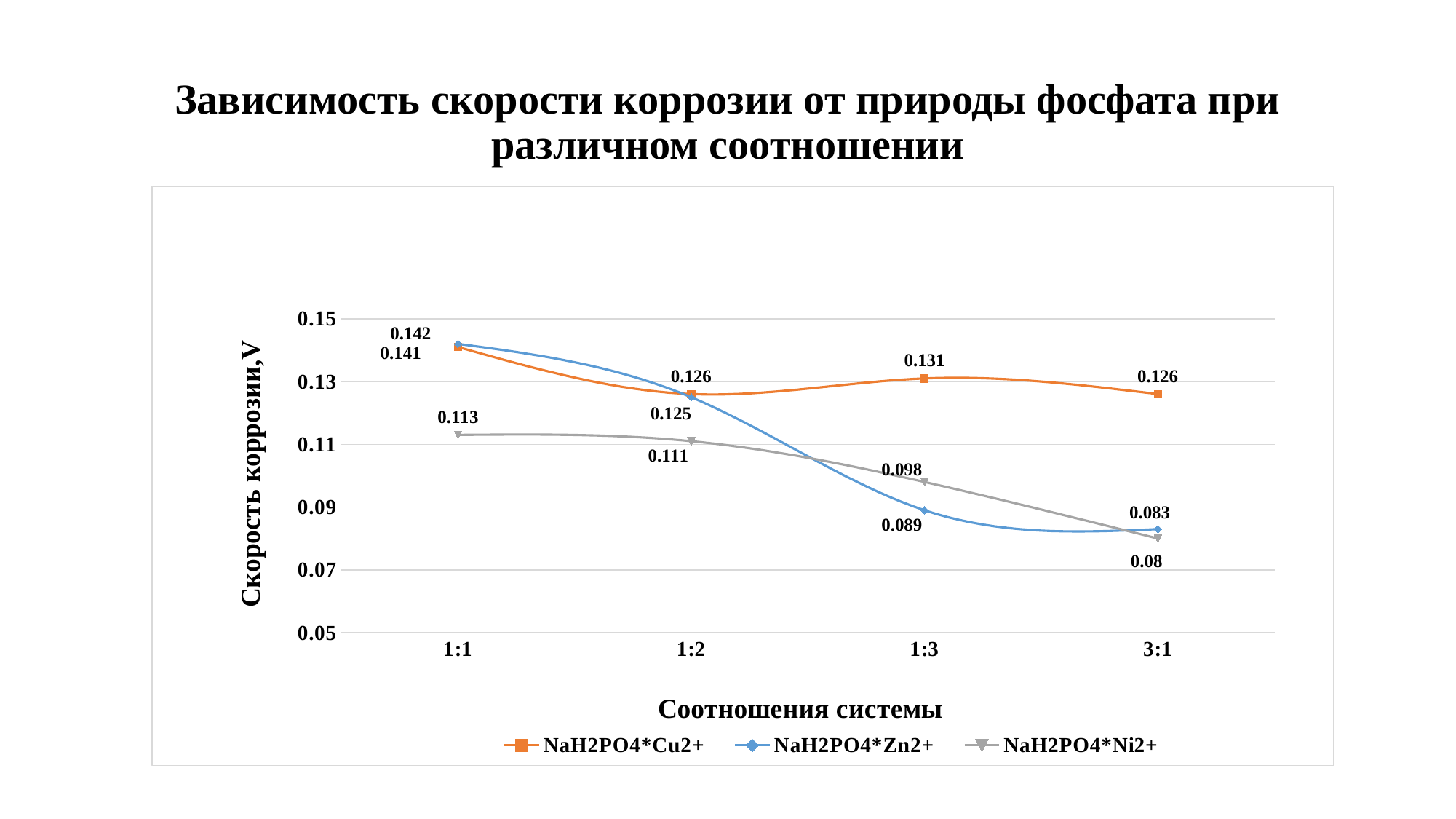
Does the NaH2PO4*Ni2+ series rise or fall from 1:1 to 3:1 along the x axis? fall What is the corrosion rate for NaH2PO4*Zn2+ at the 3:1 ratio? 0.083 What type of chart is shown on the slide? line chart What is the difference between the NaH2PO4*Cu2+ and NaH2PO4*Zn2+ values at the 1:3 ratio? 0.042 At which ratio does the NaH2PO4*Ni2+ series reach its highest value? 1:1 At which ratio does the NaH2PO4*Zn2+ series reach its lowest value? 3:1 At the 1:3 ratio, which series has the larger value: NaH2PO4*Cu2+ or NaH2PO4*Ni2+? NaH2PO4*Cu2+ What is the corrosion rate for NaH2PO4*Ni2+ at the 3:1 ratio? 0.08 What is the corrosion rate for NaH2PO4*Cu2+ at the 1:3 ratio? 0.131 How many ratio categories are shown on the x axis? 4 What is the corrosion rate for NaH2PO4*Ni2+ at the 1:1 ratio? 0.113 How many series does the legend list? 3